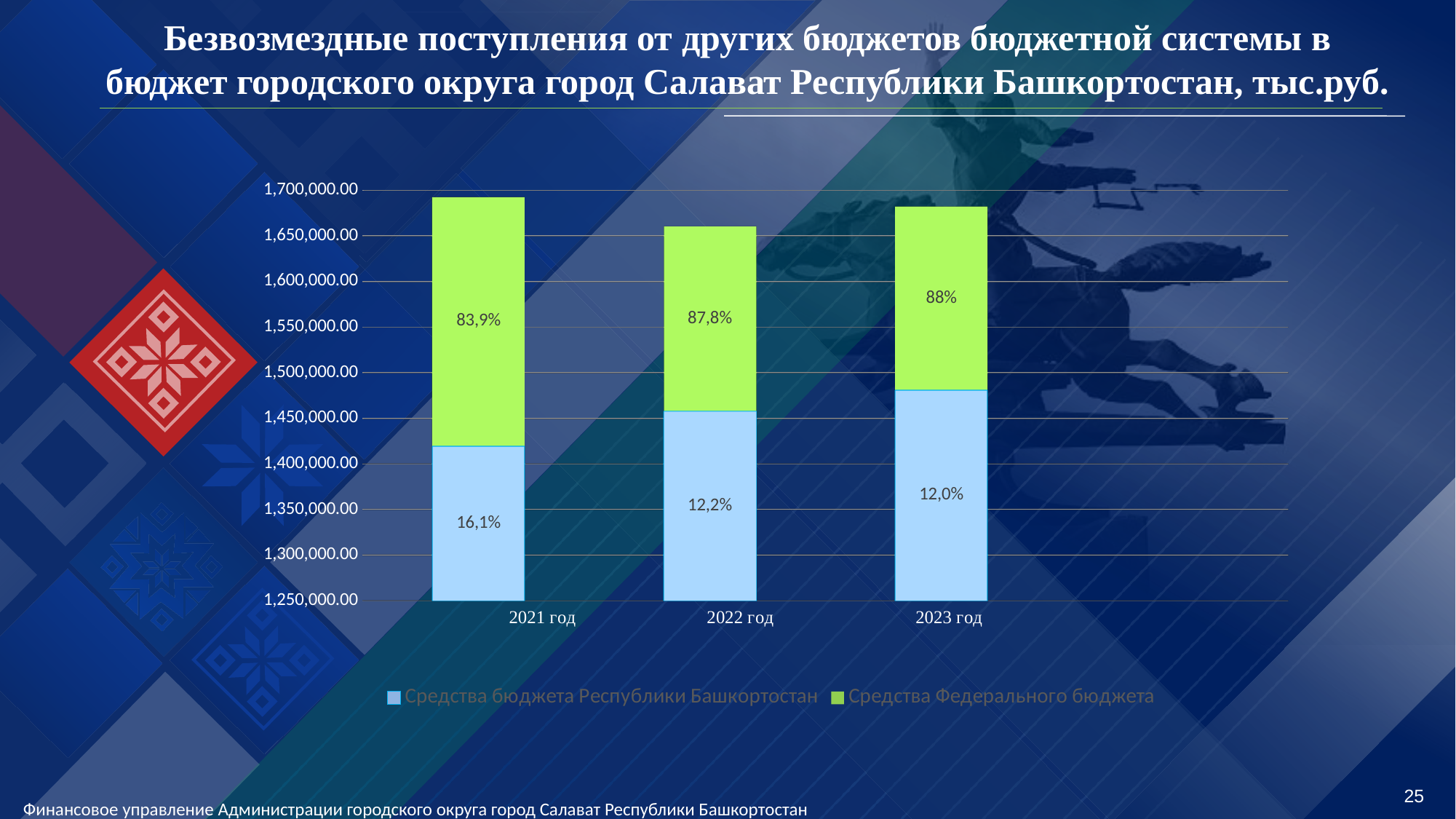
Which year has the tallest Средства бюджета Республики Башкортостан segment? 2023 год Is the top of the Средства бюджета Республики Башкортостан segment for 2021 год greater or less than 1,450,000.00? less What percentage label is shown on the Средства Федерального бюджета segment for 2023 год? 88% Is the total stacked bar for 2021 год greater or less than 1,650,000.00? greater What kind of chart is shown on the slide? Stacked bar chart Which series is shown in green in the legend? Средства Федерального бюджета How many series does the legend list? 2 What percentage label is shown on the Средства бюджета Республики Башкортостан segment for 2022 год? 12,2% Which year has the lowest total stacked bar? 2022 год What percentage label is shown on the Средства бюджета Республики Башкортостан segment for 2021 год? 16,1% How many years (categories) are shown on the x axis? 3 What percentage label is shown on the Средства Федерального бюджета segment for 2021 год? 83,9%